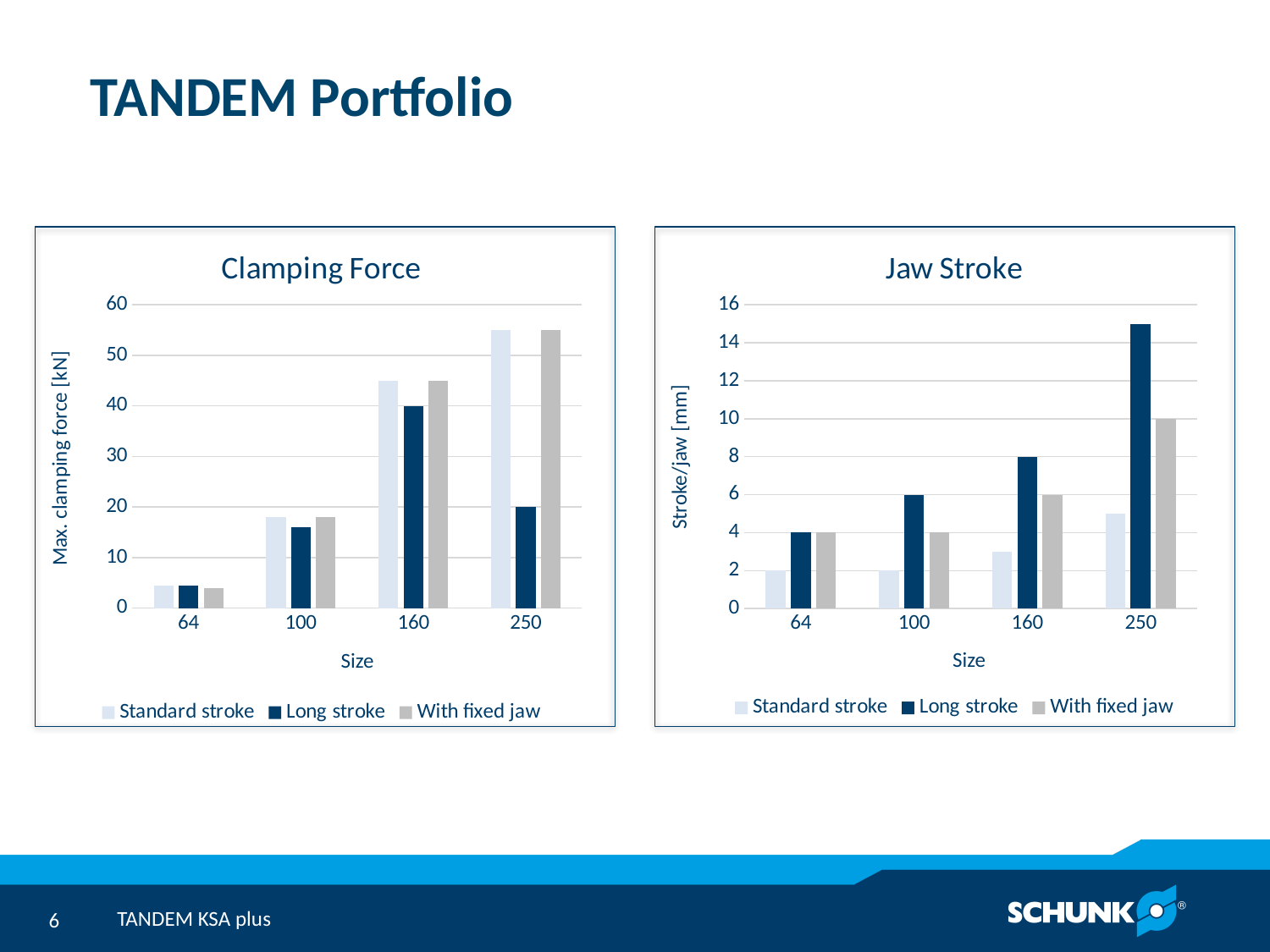
In the Clamping Force chart, is the Standard stroke value for size 250 greater or less than 50? greater In the Clamping Force chart, for size 250, which is larger: Standard stroke or Long stroke? Standard stroke In the Jaw Stroke chart, what is the Long stroke value for size 160? 8 In the Jaw Stroke chart, what is the With fixed jaw value for size 250? 10 How many series does the legend of the Jaw Stroke chart list? 3 In the Clamping Force chart, what is the Long stroke value for size 160? 40 In the Jaw Stroke chart, what is the difference between the Long stroke values for size 160 and size 64? 4 In the Clamping Force chart, what is the Long stroke value for size 250? 20 In the Jaw Stroke chart, what is the Long stroke value for size 64? 4 How many size categories are shown on the x axis of the Clamping Force chart? 4 In the Jaw Stroke chart, which size has the highest Long stroke value? 250 What kind of chart is the Clamping Force chart? bar chart